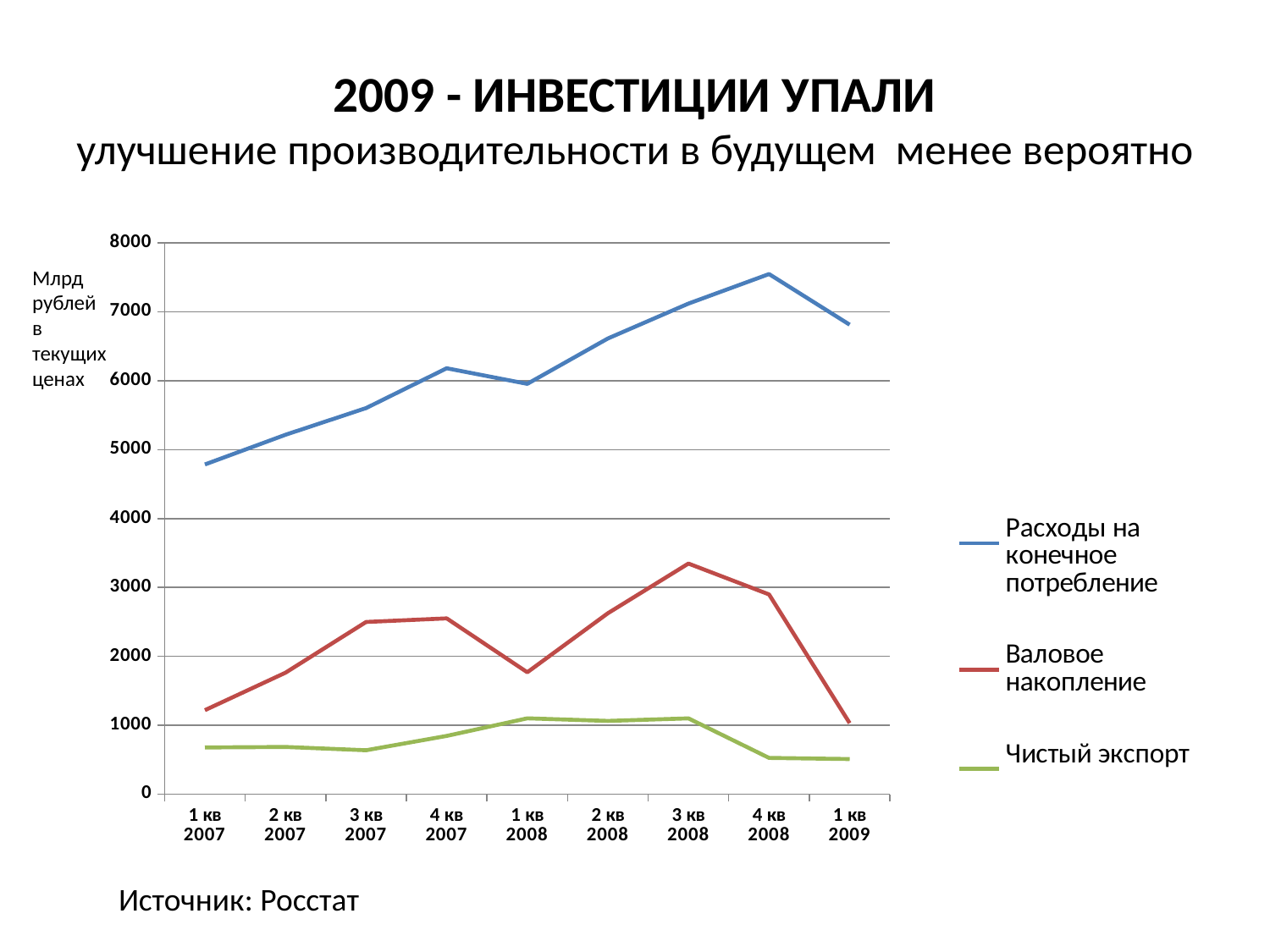
Is the value for Расходы на конечное потребление in 1 кв 2007 greater or less than 5000? less How many series does the legend list? 3 How many quarters are plotted along the x axis? 9 What kind of chart is shown on the slide? line chart In which quarter does Расходы на конечное потребление reach its highest value? 4 кв 2008 What is the source cited below the chart? Росстат Is the value for Валовое накопление in 3 кв 2008 greater or less than 3000? greater Is the value for Чистый экспорт in 4 кв 2008 greater or less than 1000? less Does Чистый экспорт rise or fall from 3 кв 2008 to 1 кв 2009? fall In which quarter is Валовое накопление at its lowest? 1 кв 2009 In which quarter does Валовое накопление reach its highest value? 3 кв 2008 In 1 кв 2009, which is larger: Валовое накопление or Чистый экспорт? Валовое накопление